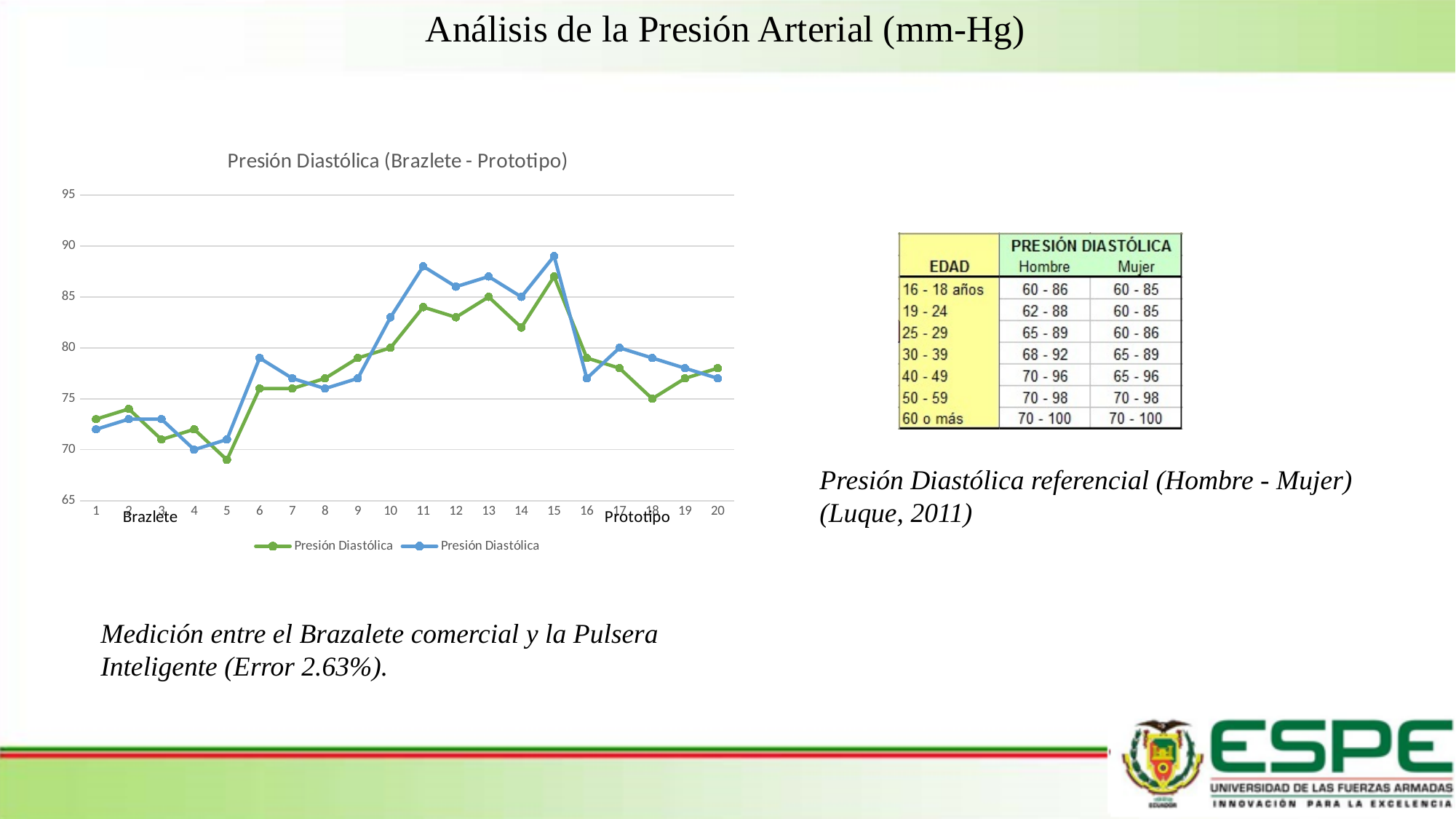
Is the value of the blue line at point 1 greater or less than 75? less At which x-axis point does the blue line reach its highest value? 15 At point 18, which line has the higher value, the blue line or the green line? blue line What is the title of the chart? Presión Diastólica (Brazlete - Prototipo) How many series does the chart legend list? 2 Is the value of the green line at point 11 greater or less than 80? greater How many measurement points are plotted along the x axis of the chart? 20 At which x-axis point does the green line reach its lowest value? 5 Is the value of the green line at point 5 greater or less than 70? less Do the values of the blue line generally rise or fall from point 5 to point 15? rise What kind of chart is shown on the slide? line chart At point 14, which line has the higher value, the blue line or the green line? blue line